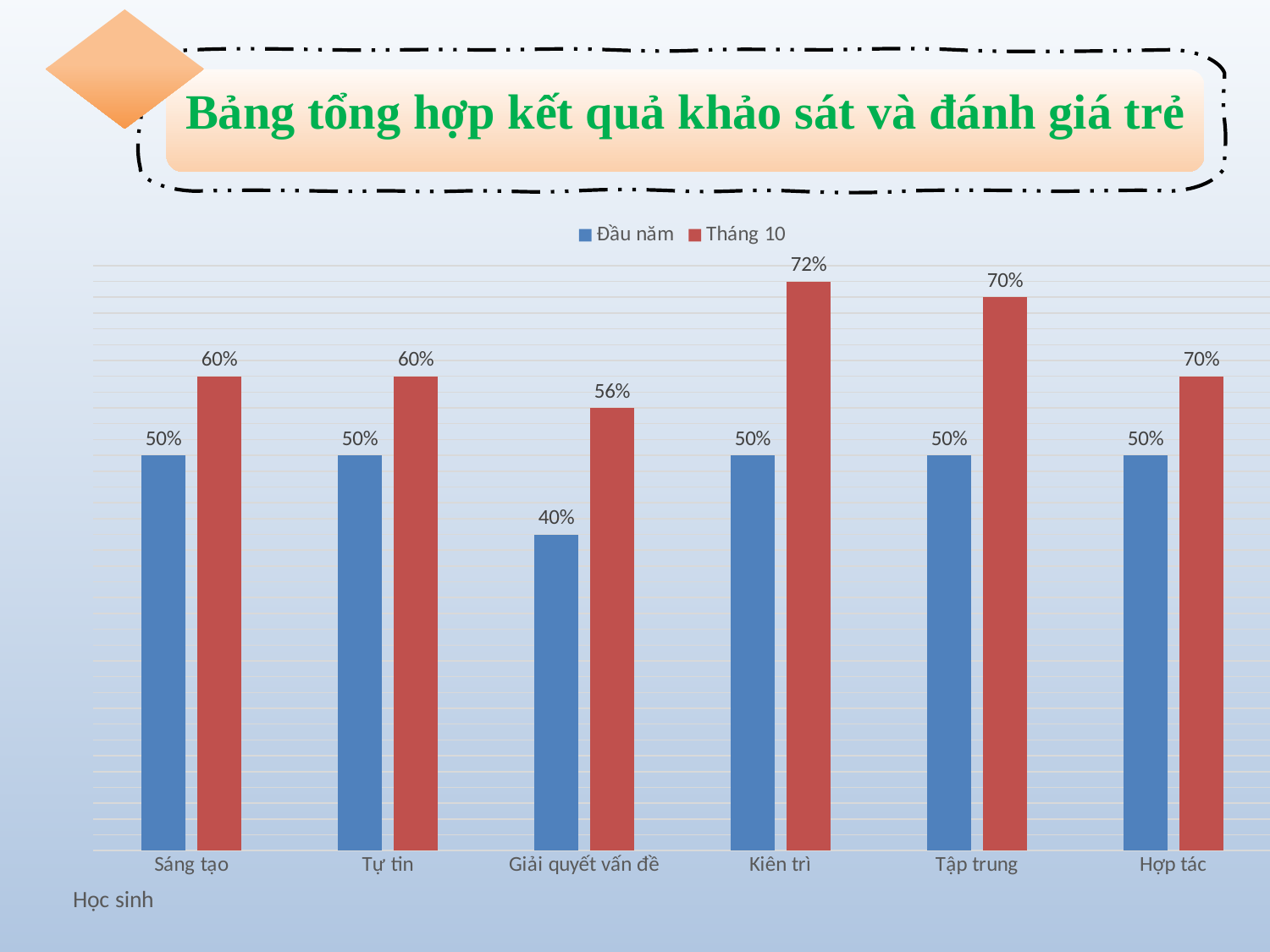
How many categories are shown on the x axis? 6 What is the difference between the Tháng 10 and Đầu năm values for Tập trung? 20% Which is larger: the Tháng 10 value for Hợp tác or the Tháng 10 value for Tự tin? Hợp tác What is the Đầu năm value for Giải quyết vấn đề? 40% What are the two series named in the legend? Đầu năm and Tháng 10 What is the difference between the Tháng 10 values for Kiên trì and Sáng tạo? 12% What is the Tháng 10 value for Kiên trì? 72% Which category has the highest Tháng 10 value? Kiên trì What is the Tháng 10 value for Giải quyết vấn đề? 56% Which category has the lowest Đầu năm value? Giải quyết vấn đề How many series does the legend list? 2 What kind of chart is shown on the slide? Bar chart